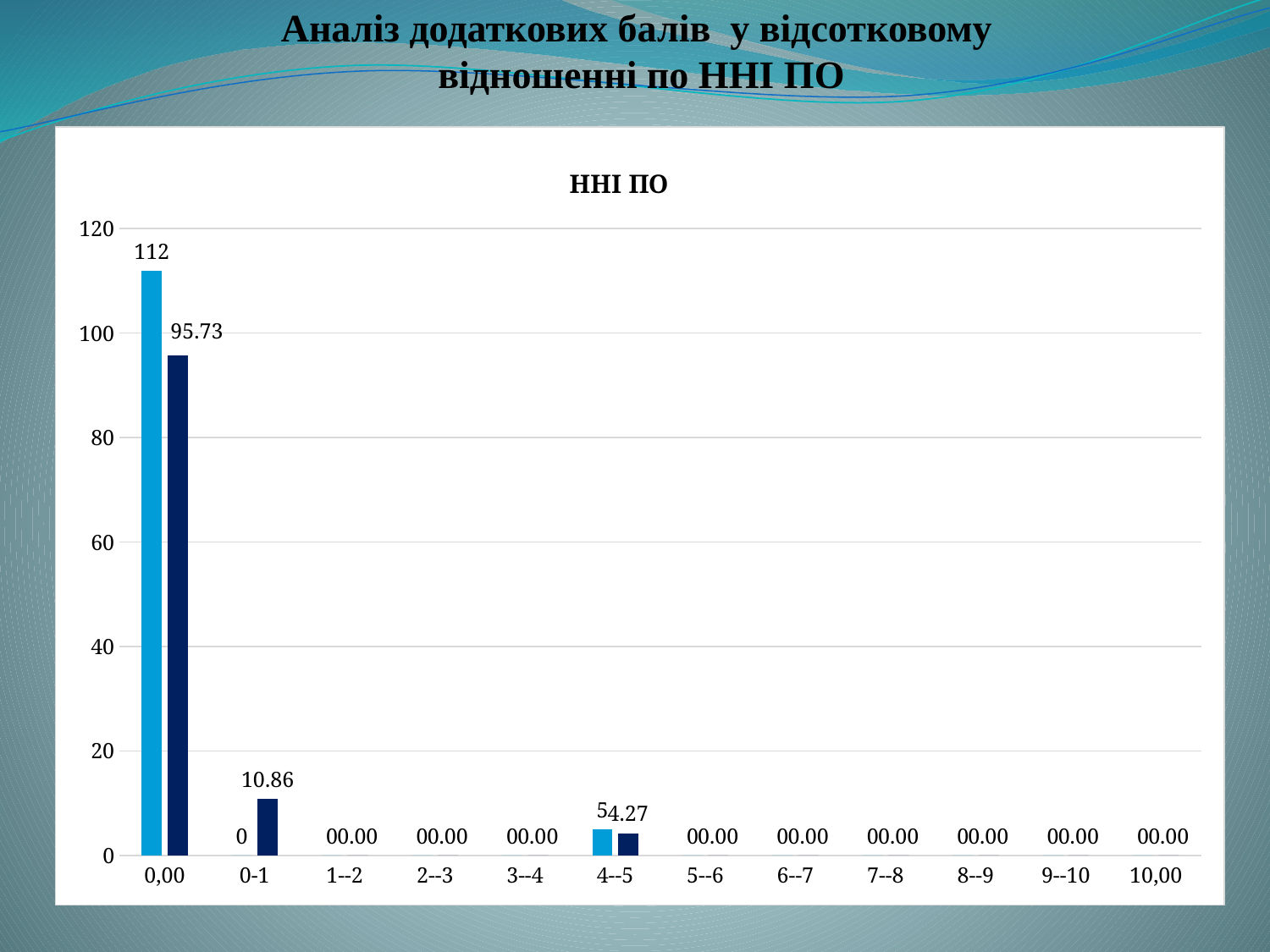
Which category has the tallest bar in the chart? 0,00 What is the value of the dark blue bar for the category 0-1? 10.86 For the category 0,00, which bar is larger, the light blue or the dark blue one? light blue What is the difference between the light blue and dark blue bars for the category 0,00? 16.27 What is the title of the chart? ННІ ПО What is the value of the light blue bar for the category 0,00? 112 How many categories are shown on the x axis of the chart? 12 What is the value of the light blue bar for the category 0-1? 0 Is the value of the light blue bar for 0,00 greater or less than 100? greater What is the value of the dark blue bar for the category 0,00? 95.73 What is the highest value shown on the y axis of the chart? 120 What kind of chart is shown on the slide? bar chart